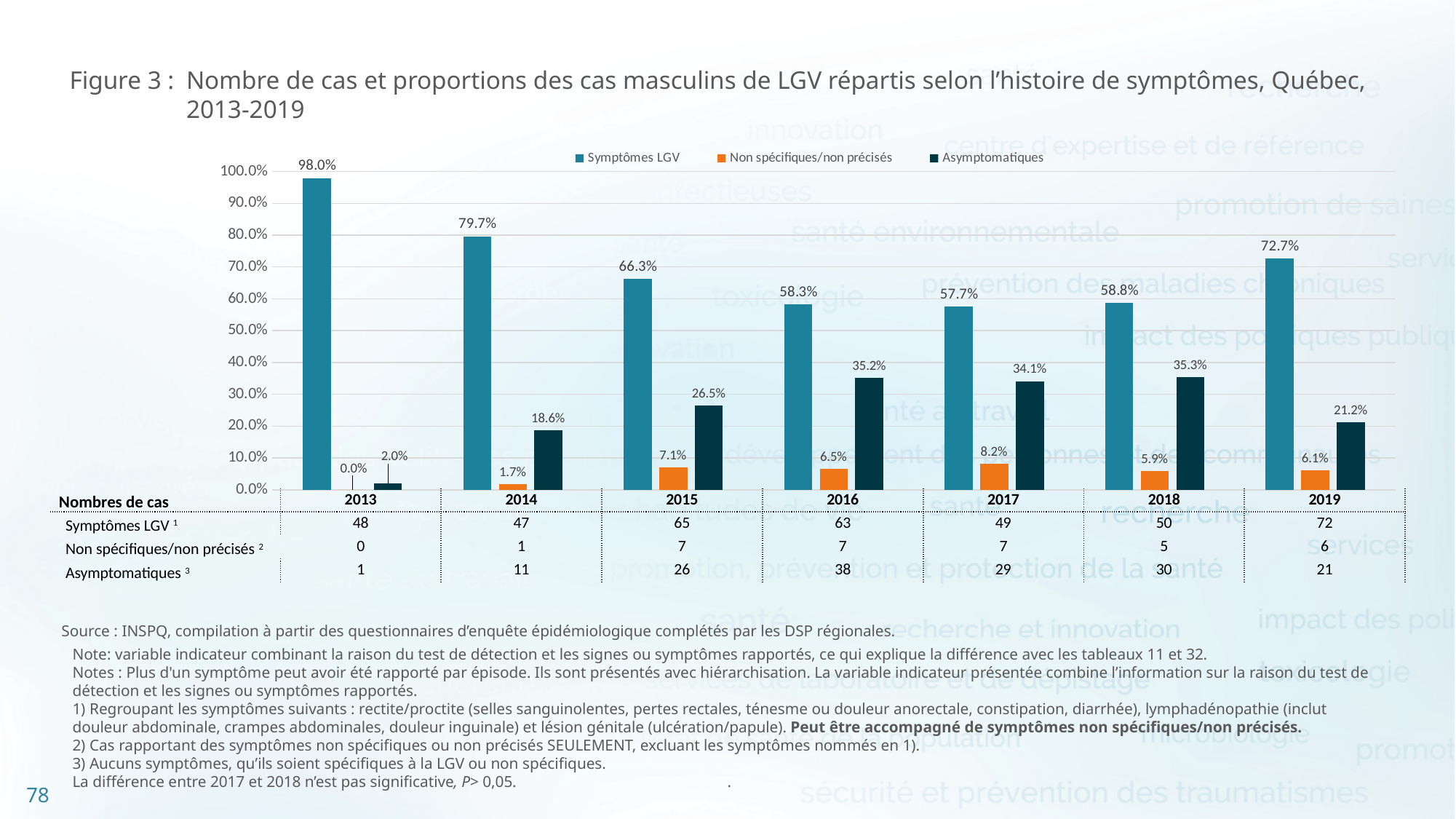
What percentage is shown for Non spécifiques/non précisés in 2017? 8.2% What is the difference between the Symptômes LGV percentages in 2013 and 2014? 18.3% Is the Symptômes LGV value for 2015 greater or less than 60.0%? greater In which year is the Symptômes LGV percentage the lowest? 2017 What percentage is shown for Asymptomatiques in 2016? 35.2% What percentage is shown for Symptômes LGV in 2013? 98.0% Which series is drawn in orange? Non spécifiques/non précisés In which year is the Asymptomatiques percentage the highest? 2018 How many series does the legend list? 3 How many years are shown on the x axis? 7 What kind of chart is shown? Bar chart Which is larger in 2019: the Symptômes LGV percentage or the Asymptomatiques percentage? Symptômes LGV